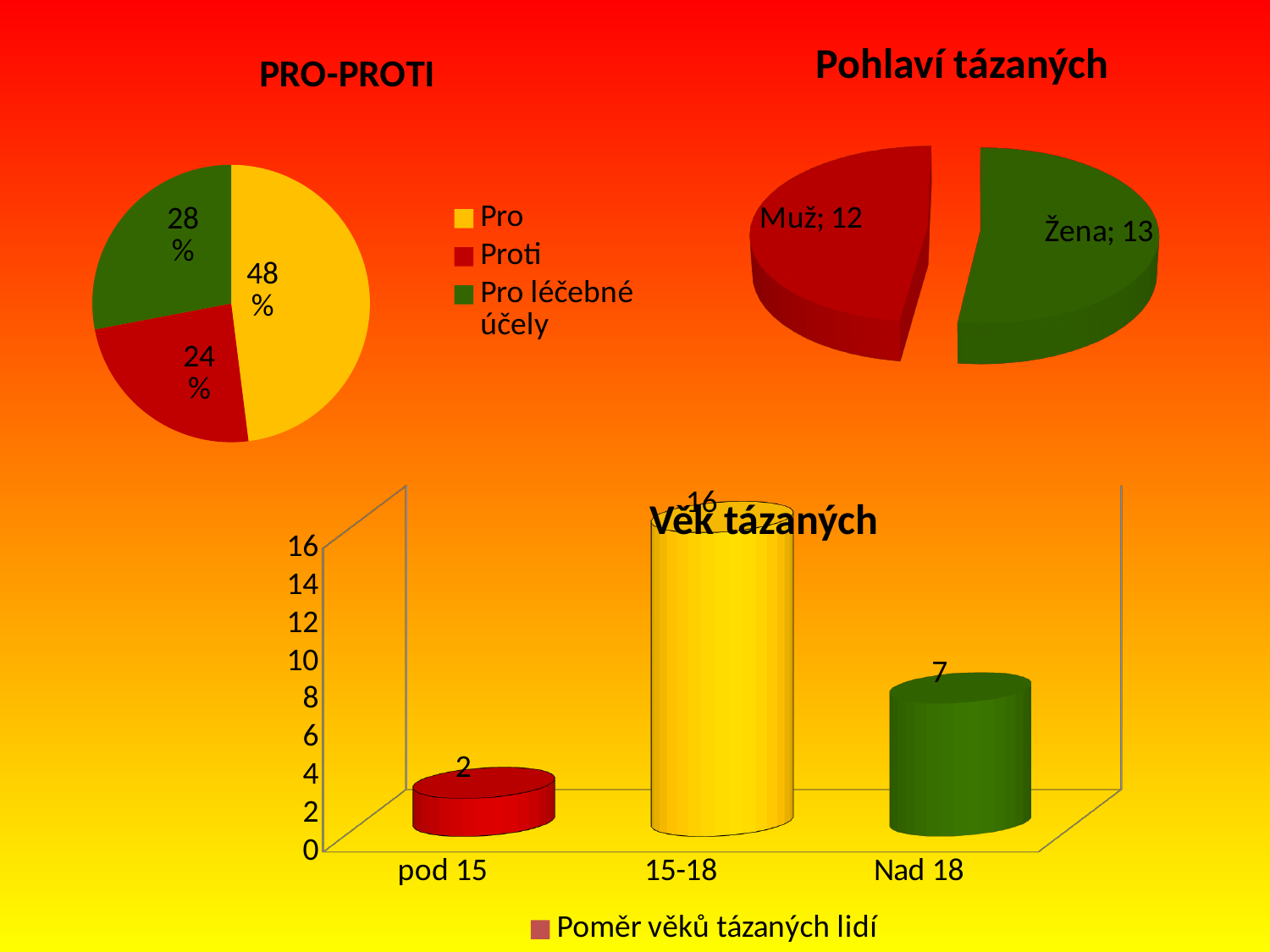
In the Pohlaví tázaných chart, what is the difference between the values for Žena and Muž? 1 In the Věk tázaných chart, what is the difference between the values for 15-18 and Nad 18? 9 In the PRO-PROTI chart, what share of the pie is labelled Pro? 48% In the Pohlaví tázaných chart, what is the value for Žena? 13 In the Věk tázaných chart, what is the value for 15-18? 16 In the PRO-PROTI chart, how many entries does the legend list? 3 In the Pohlaví tázaných chart, what is the value for Muž? 12 In the PRO-PROTI chart, what share of the pie is labelled Proti? 24% In the PRO-PROTI chart, which category has the smallest slice? Proti In the Věk tázaných chart, which category has the lowest value? pod 15 In the PRO-PROTI chart, which category has the largest slice? Pro What kind of chart is the Věk tázaných chart? Bar chart